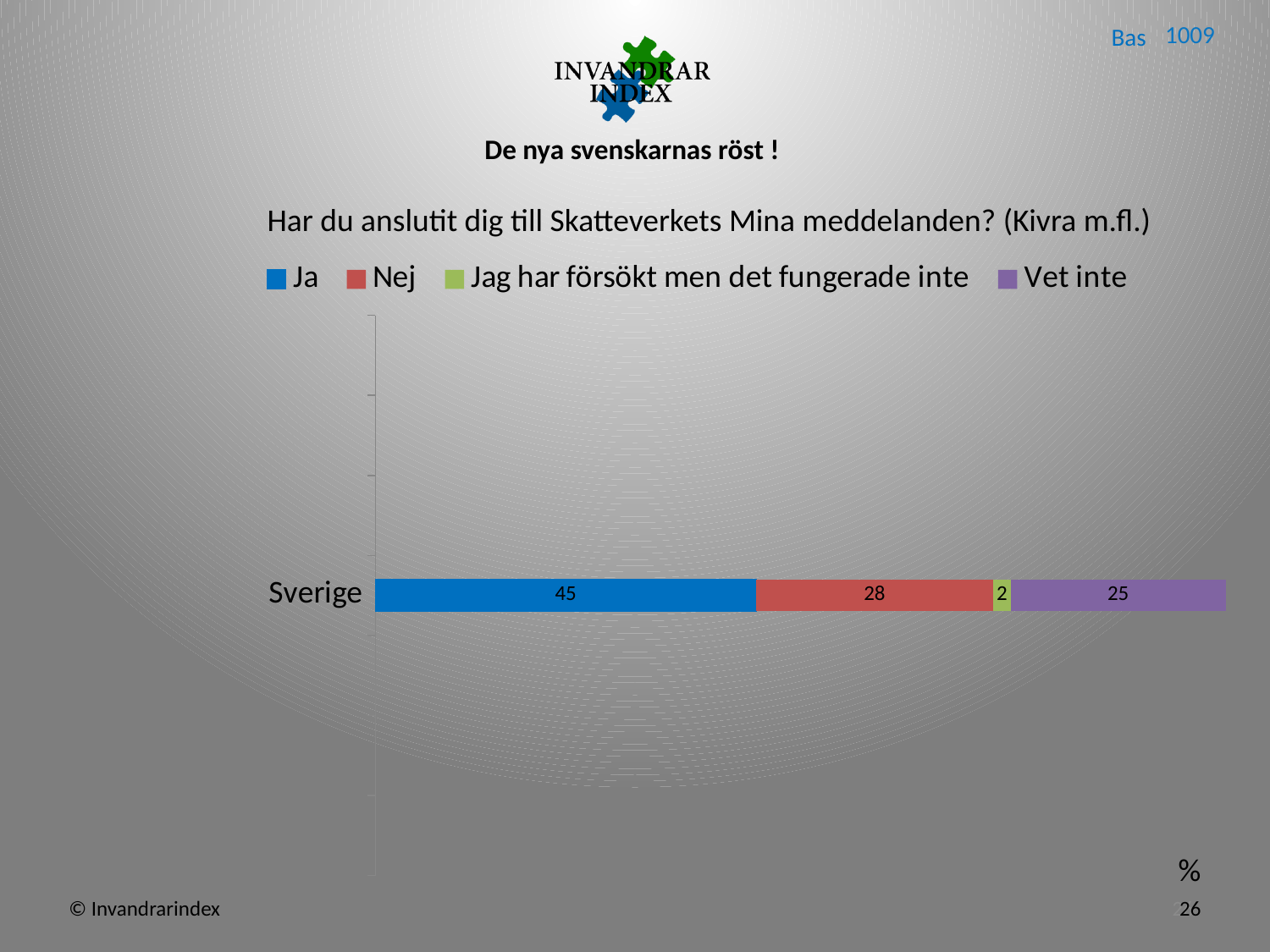
What is the value for "Nej" for Sverige? 28 Which series has the highest value for Sverige? Ja What is the total of the stacked bar for Sverige? 100 What is the value for "Vet inte" for Sverige? 25 What is the difference between the "Ja" and "Nej" values for Sverige? 17 How many series does the legend list? 4 Which is larger for Sverige, "Nej" or "Vet inte"? Nej What is the value for "Jag har försökt men det fungerade inte" for Sverige? 2 What kind of chart is shown on the slide? Stacked bar chart Which series has the lowest value for Sverige? Jag har försökt men det fungerade inte What is the value for "Ja" for Sverige? 45 What is the title of the chart? Har du anslutit dig till Skatteverkets Mina meddelanden? (Kivra m.fl.)